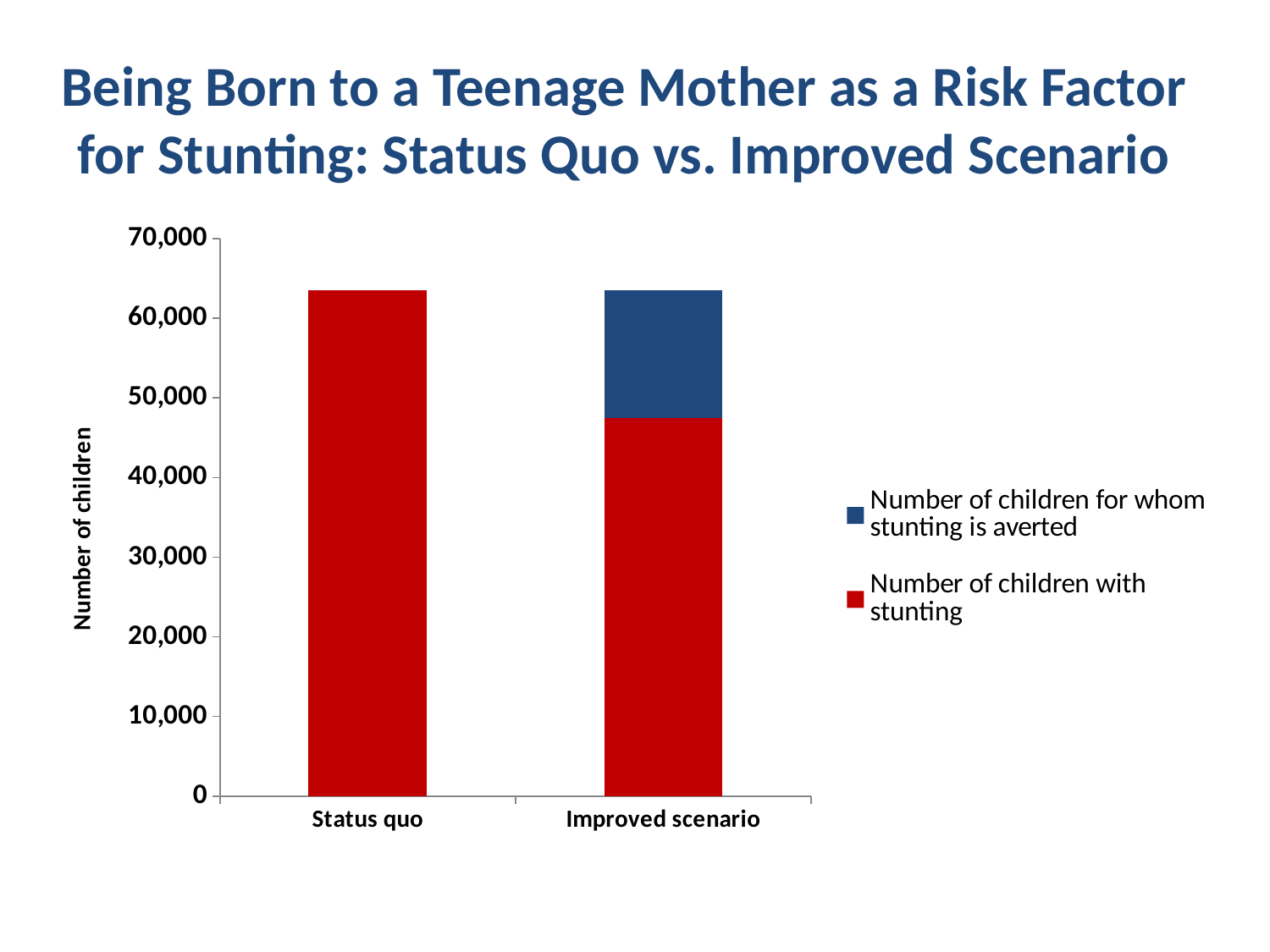
In the Improved scenario, which is larger: "Number of children with stunting" or "Number of children for whom stunting is averted"? Number of children with stunting Is the value for "Number of children with stunting" in the Status quo greater or less than 60,000? greater How many series does the chart's legend list? 2 Which series is shown in blue in the chart? Number of children for whom stunting is averted What is the label of the chart's vertical axis? Number of children Which category has the higher value for "Number of children with stunting"? Status quo Is the value for "Number of children with stunting" in the Improved scenario greater or less than 40,000? greater Is the value for "Number of children with stunting" in the Improved scenario greater or less than 50,000? less How many categories are shown on the x axis of the chart? 2 Which category has the lower value for "Number of children with stunting"? Improved scenario What kind of chart is shown on the slide? Stacked bar chart Is the "Number of children with stunting" larger in the Status quo or in the Improved scenario? Status quo